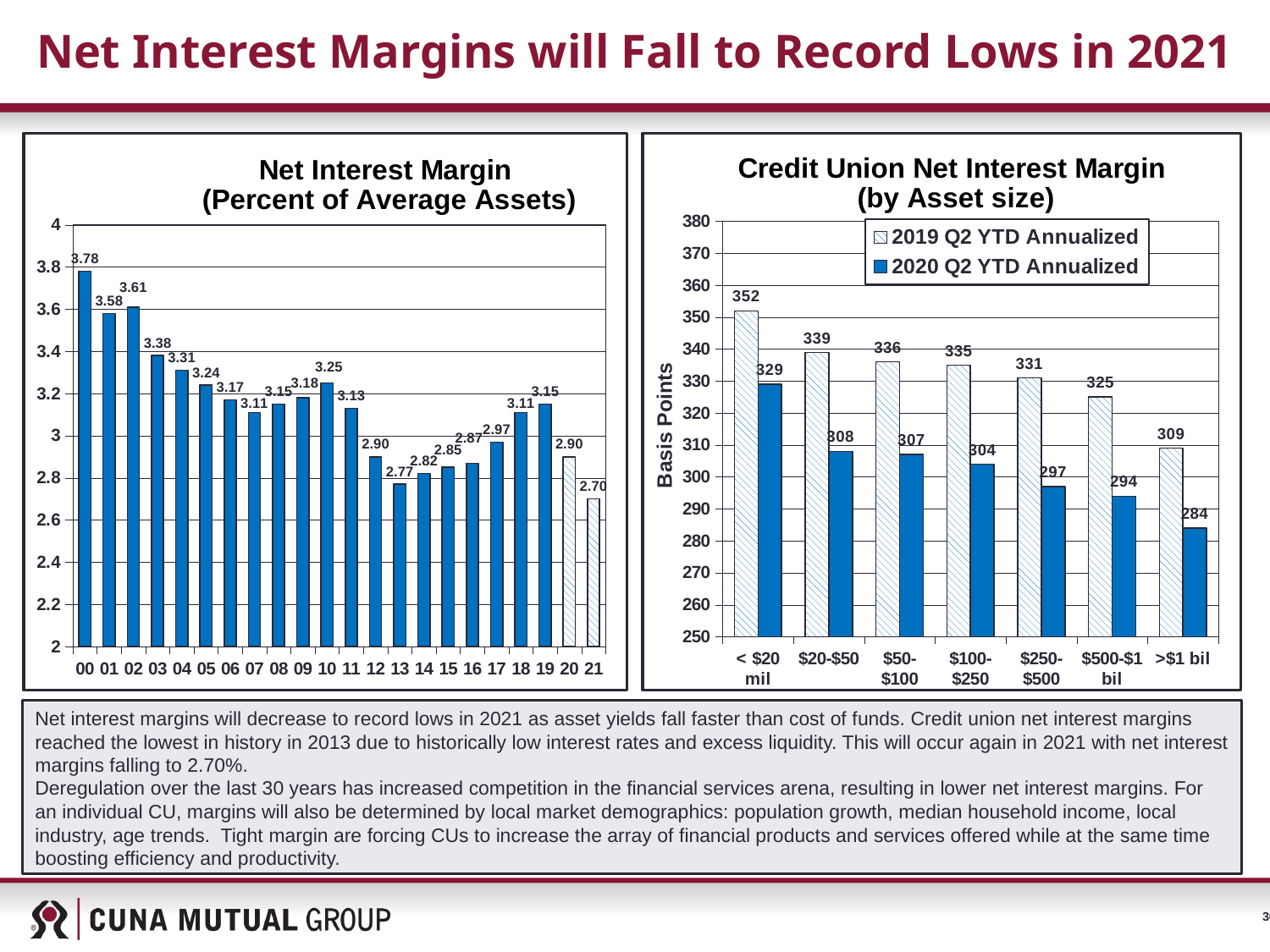
In the Credit Union Net Interest Margin (by Asset size) chart, which is larger: the 2020 Q2 YTD Annualized value for $20-$50 or for $250-$500? $20-$50 In the Net Interest Margin (Percent of Average Assets) chart, what is the value for 2013? 2.77 In the Net Interest Margin (Percent of Average Assets) chart, is the value for 2010 greater or less than 3.2? greater In the Credit Union Net Interest Margin (by Asset size) chart, what is the 2019 Q2 YTD Annualized value for the < $20 mil asset group? 352 What kind of chart is the Credit Union Net Interest Margin (by Asset size) chart? Bar chart In the Credit Union Net Interest Margin (by Asset size) chart, what is the 2020 Q2 YTD Annualized value for the >$1 bil asset group? 284 In the Net Interest Margin (Percent of Average Assets) chart, what is the difference between the values for 2000 and 2021? 1.08 In the Net Interest Margin (Percent of Average Assets) chart, which year has the lowest value? 21 In the Net Interest Margin (Percent of Average Assets) chart, which year has the highest value? 00 In the Net Interest Margin (Percent of Average Assets) chart, how many years are plotted? 22 In the Credit Union Net Interest Margin (by Asset size) chart, what is the difference between the 2019 and 2020 Q2 YTD Annualized values for the $100-$250 asset group? 31 In the Credit Union Net Interest Margin (by Asset size) chart, how many series does the legend list? 2